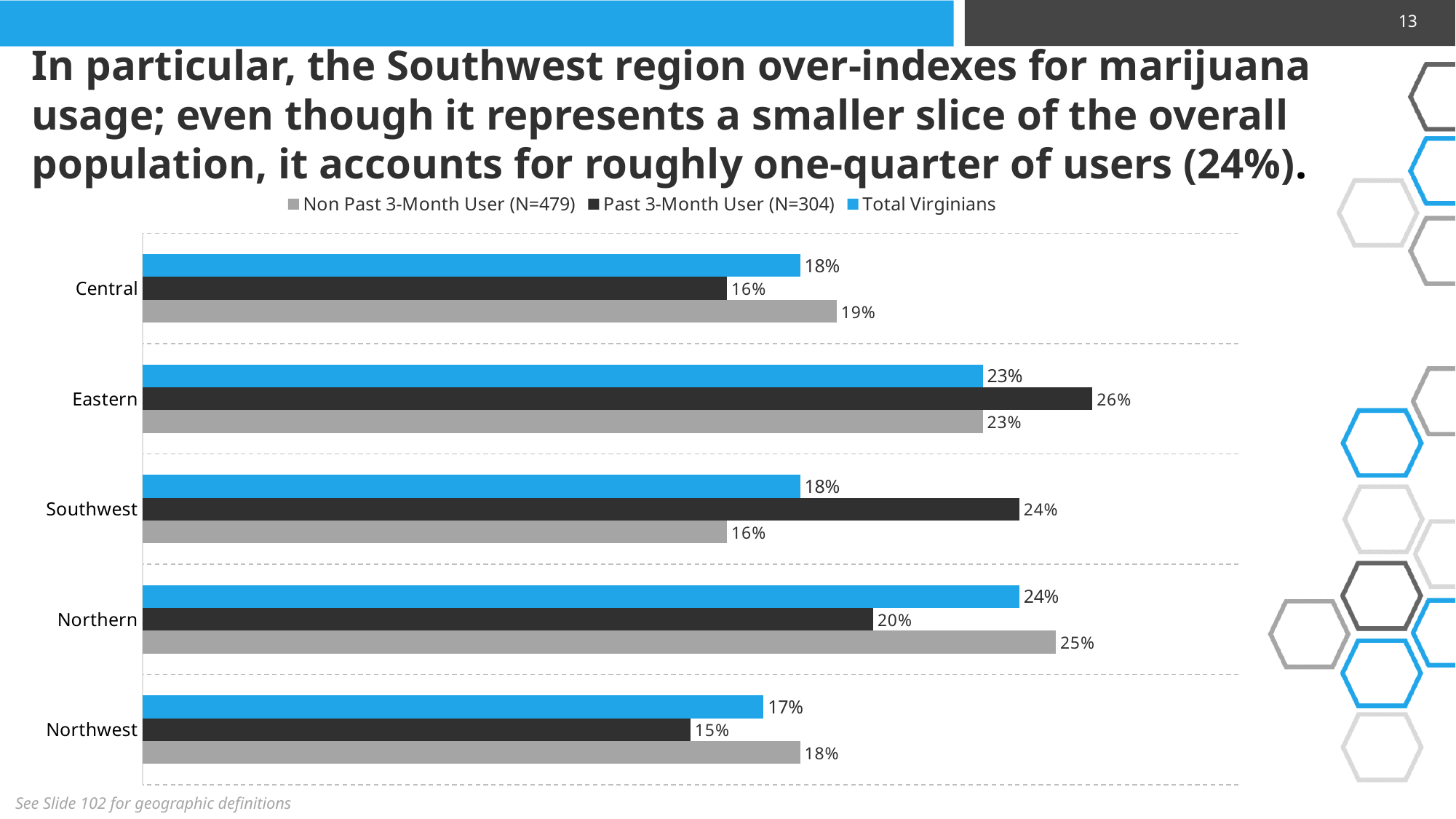
What kind of chart is shown on the slide? Bar chart What colour are the Total Virginians bars? Blue Which region has the highest Past 3-Month User (N=304) value? Eastern How many series does the legend list? 3 Which region has the lowest Past 3-Month User (N=304) value? Northwest What is the Total Virginians value for the Northern region? 24% For the Northern region, which is larger: the Past 3-Month User value or the Non Past 3-Month User value? Non Past 3-Month User What is the Past 3-Month User (N=304) value for the Southwest region? 24% Which region has the highest Non Past 3-Month User (N=479) value? Northern What is the Non Past 3-Month User (N=479) value for the Central region? 19% How many regions are shown on the chart? 5 What is the difference between the Past 3-Month User and Non Past 3-Month User values for the Southwest region? 8 percentage points